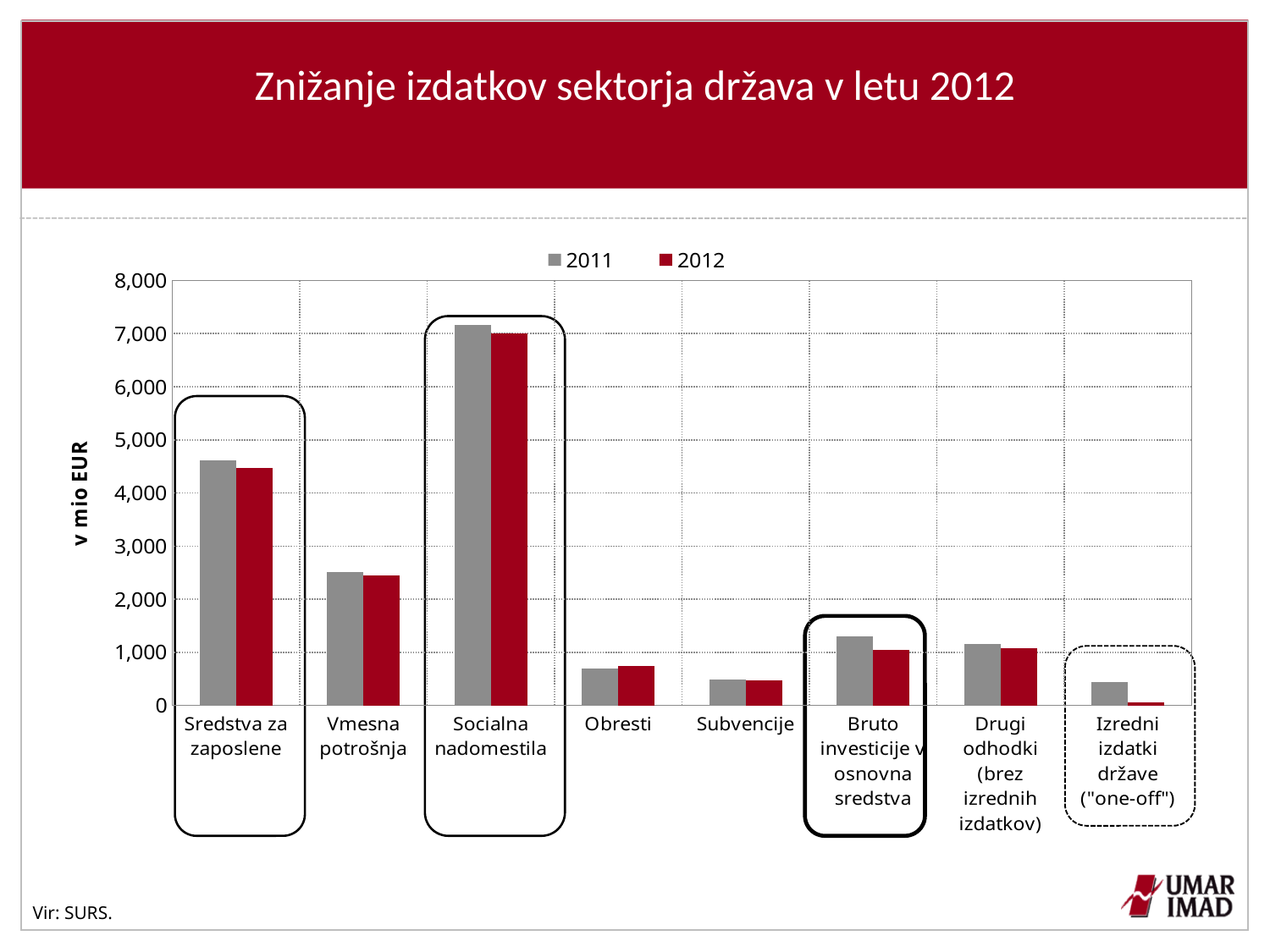
Is the 2011 value for Sredstva za zaposlene greater or less than 4,000? greater Which category has the highest value for 2011? Socialna nadomestila Is the 2011 value for Bruto investicije v osnovna sredstva greater or less than 1,000? greater How many categories are shown on the x axis? 8 Which category has the lowest value for 2012? Izredni izdatki države ("one-off") For Obresti, which year has the larger value, 2011 or 2012? 2012 Is the 2011 value for Obresti greater or less than 1,000? less How many series does the legend list? 2 What kind of chart is shown on the slide? bar chart For Bruto investicije v osnovna sredstva, which year has the larger value, 2011 or 2012? 2011 What is the label of the vertical axis? v mio EUR